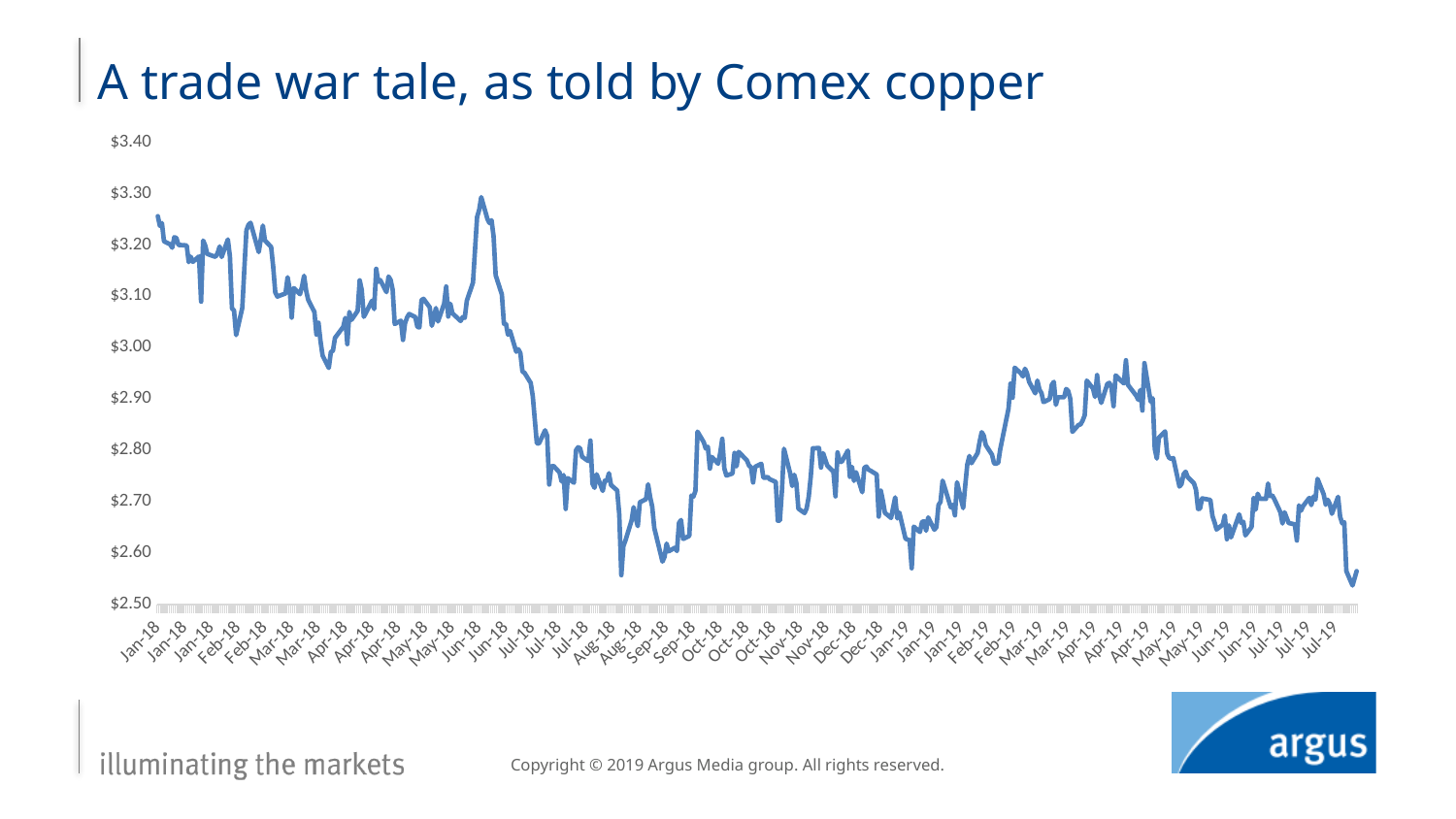
Which is higher, the copper price in Jan-18 or in Jul-19? Jan-18 Is the peak copper price reached in Jun-18 greater or less than $3.20? greater Does the copper price rise or fall between Jan-19 and Apr-19? rise What is the title of the chart on the slide? A trade war tale, as told by Comex copper Is the lowest copper price in Aug-18 greater or less than $2.70? less Which is higher, the peak copper price in Jun-18 or the peak in Apr-19? Jun-18 What is the highest value shown on the vertical axis of the chart? $3.40 Is the copper price at the end of the series in Jul-19 greater or less than $2.70? less What kind of chart is shown on the slide? line chart Overall, does the copper price rise or fall from Jan-18 to Jul-19? fall